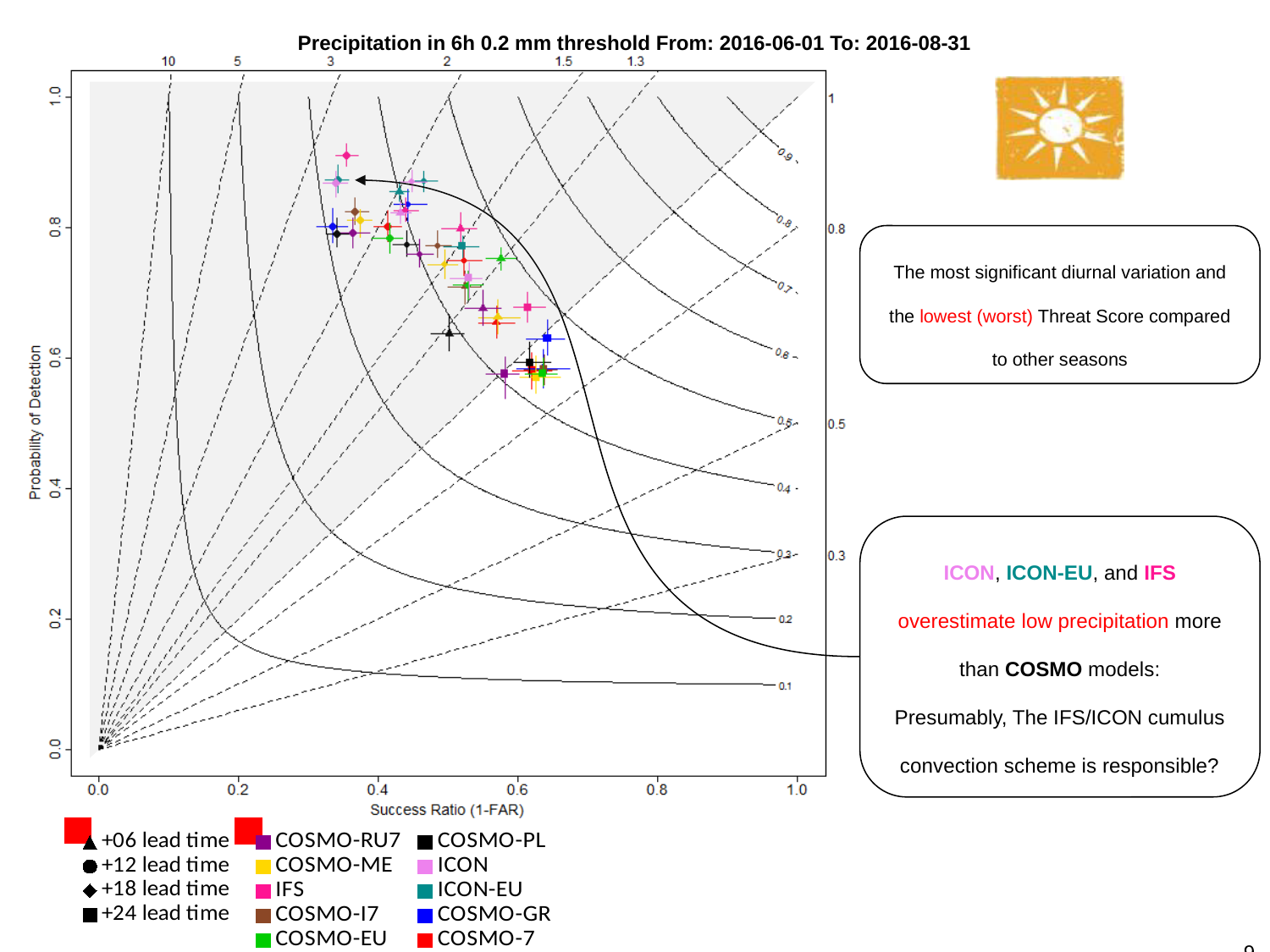
How many models are listed in the chart's colour legend? 10 How many lead times are listed in the chart's marker legend? 4 What is the title of the chart? Precipitation in 6h 0.2 mm threshold From: 2016-06-01 To: 2016-08-31 Is the highest plotted Probability of Detection value greater or less than 0.8? greater What is the label of the x axis of the chart? Success Ratio (1-FAR) What kind of chart is shown on the slide? scatter plot Is the largest plotted Success Ratio value greater or less than 0.8? less Is the smallest plotted Success Ratio value greater or less than 0.2? greater